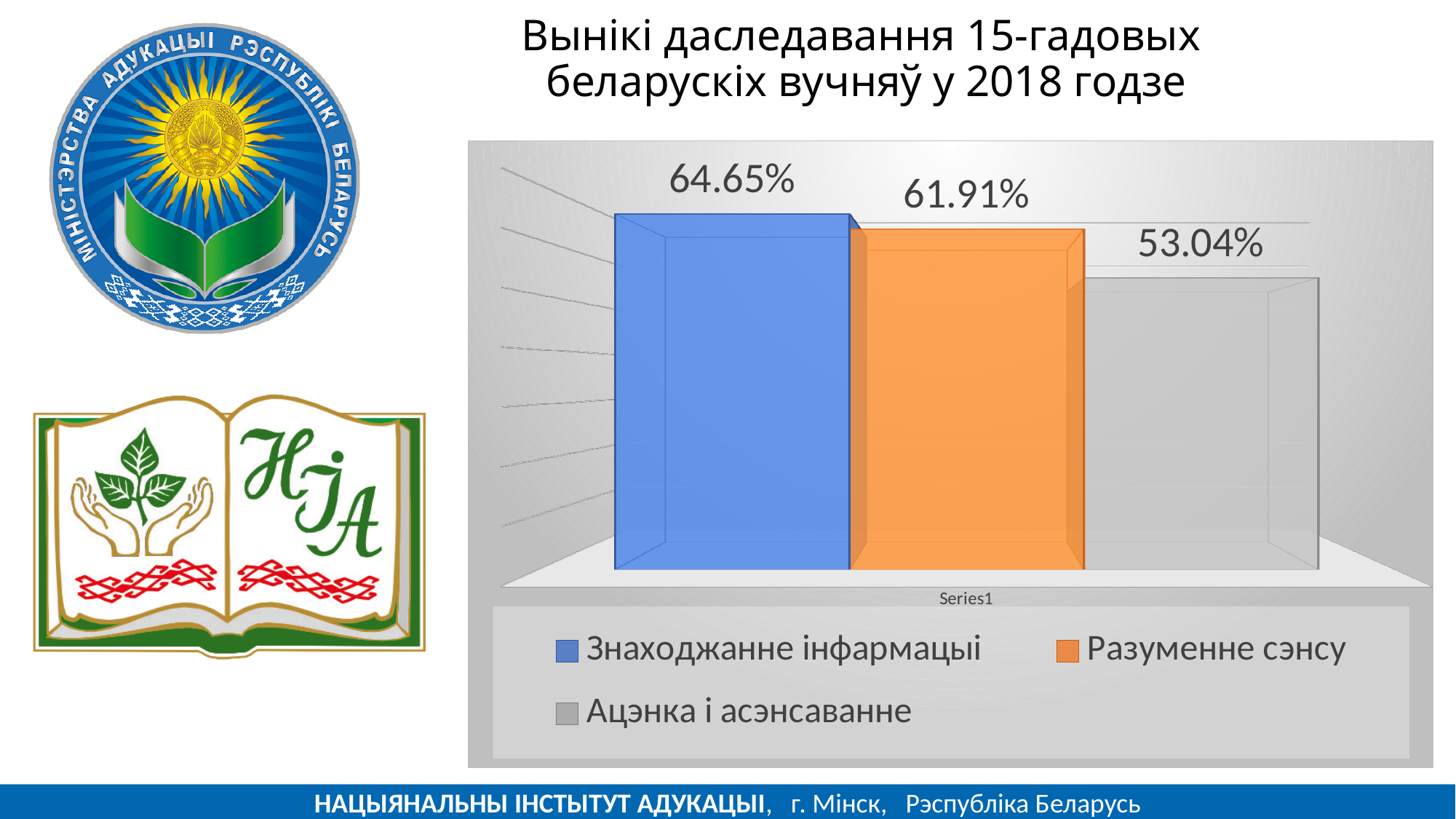
How many series does the legend list? 3 What value is shown for Ацэнка і асэнсаванне? 53.04% What is the difference between the values for Знаходжанне інфармацыі and Разуменне сэнсу? 2.74% What kind of chart is shown on the slide? Bar chart Which series has the lowest value? Ацэнка і асэнсаванне What value is shown for Знаходжанне інфармацыі? 64.65% Which is larger, the value for Разуменне сэнсу or the value for Ацэнка і асэнсаванне? Разуменне сэнсу What value is shown for Разуменне сэнсу? 61.91% What colour is the bar for Разуменне сэнсу? Orange Which series has the highest value? Знаходжанне інфармацыі What is the difference between the values for Знаходжанне інфармацыі and Ацэнка і асэнсаванне? 11.61% What label appears on the category axis below the bars? Series1